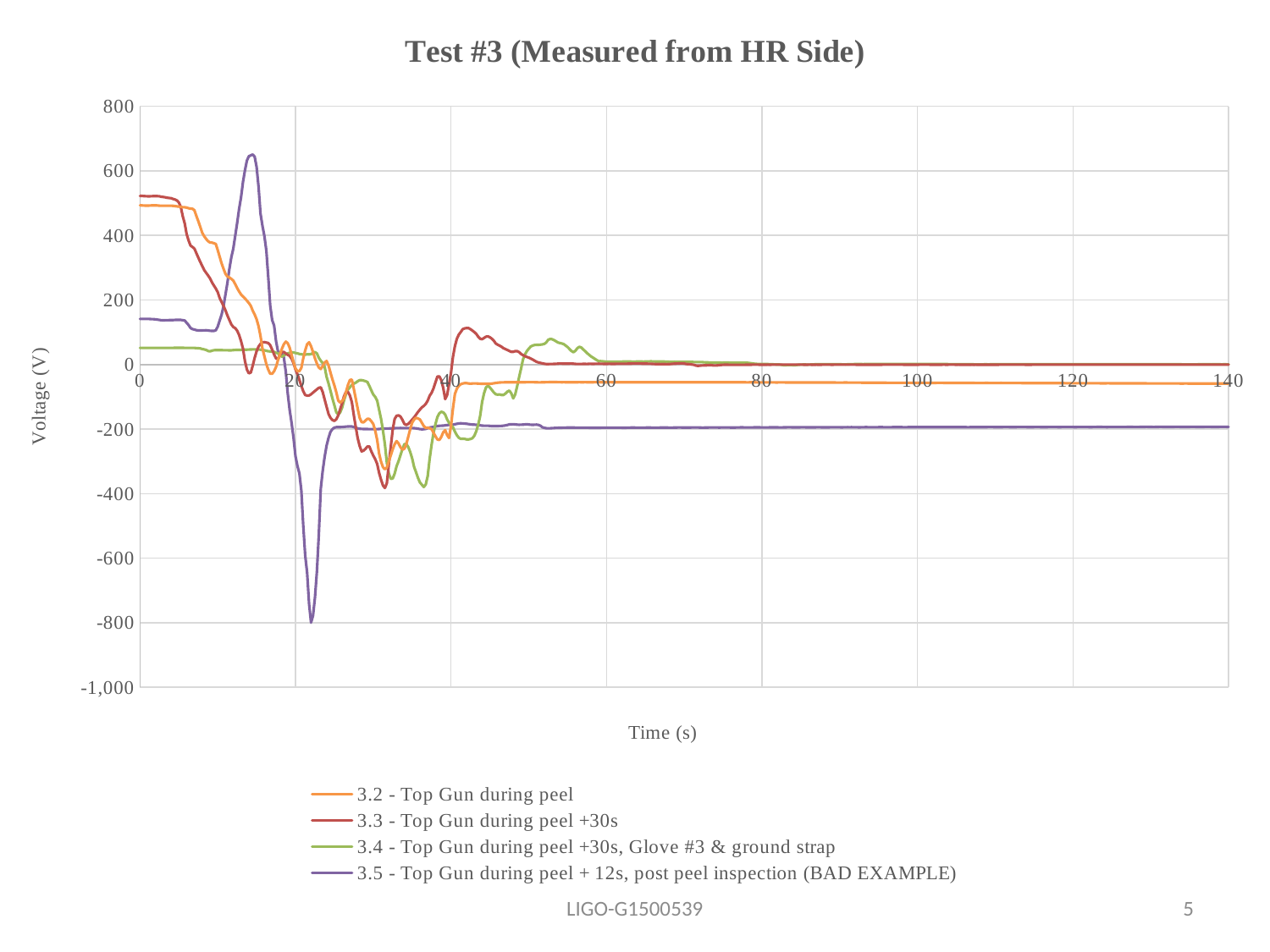
Which series reaches the highest voltage anywhere on the chart? 3.5 - Top Gun during peel + 12s, post peel inspection (BAD EXAMPLE) At time 140 s, which series has the lowest voltage? 3.5 - Top Gun during peel + 12s, post peel inspection (BAD EXAMPLE) Is the lowest value of the series 3.5 - Top Gun during peel + 12s greater or less than -600? less What is the title of the chart? Test #3 (Measured from HR Side) What kind of chart is shown on the slide? line chart What is the label of the vertical axis? Voltage (V) Is the value of the series 3.3 - Top Gun during peel +30s at time 0 greater or less than 400? greater Which series reaches the lowest voltage anywhere on the chart? 3.5 - Top Gun during peel + 12s, post peel inspection (BAD EXAMPLE) How many series does the legend list? 4 Does the series 3.2 - Top Gun during peel rise or fall between time 0 and time 40 s? fall At time 140 s, is the value of the series 3.2 - Top Gun during peel greater or less than 0? less